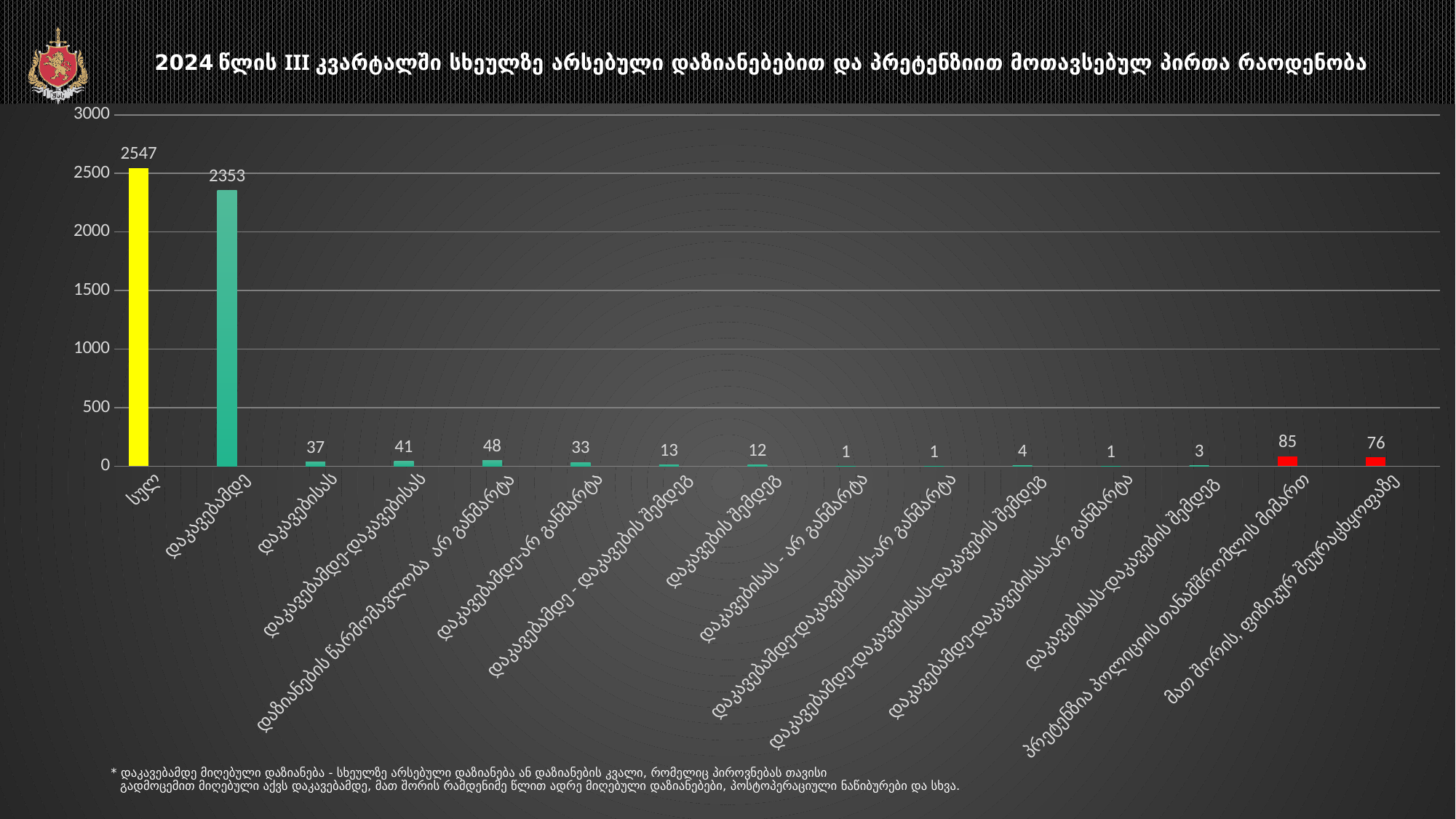
What is the value for the bar labelled "სულ"? 2547 What is the value for the bar labelled "მათ შორის, ფიზიკურ შეურაცხყოფაზე"? 76 What is the value for the bar labelled "დაკავების შემდეგ"? 12 What kind of chart is shown on the slide? bar chart What is the value for the bar labelled "პრეტენზია პოლიციის თანამშრომლის მიმართ"? 85 How many categories are shown on the x axis? 15 Which category has the highest value? სულ Which is larger, the value for "დაკავებისას" or the value for "დაკავებამდე-დაკავებისას"? დაკავებამდე-დაკავებისას What is the difference between the values for "პრეტენზია პოლიციის თანამშრომლის მიმართ" and "მათ შორის, ფიზიკურ შეურაცხყოფაზე"? 9 What is the difference between the values for "სულ" and "დაკავებამდე"? 194 What is the value for the bar labelled "დაკავებამდე"? 2353 Is the value for "დაკავებამდე" greater or less than 2000? greater